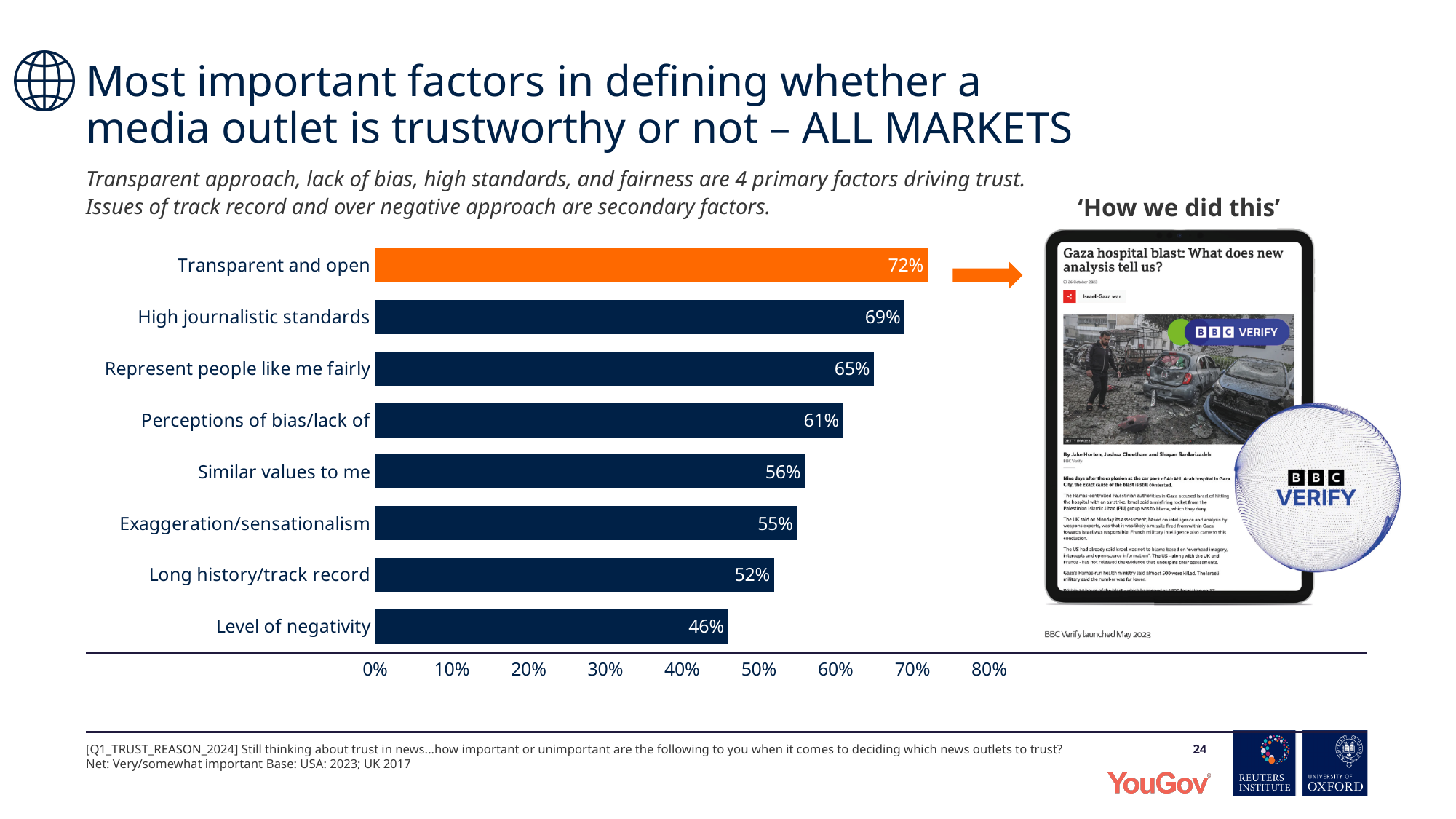
How many factors are shown in the chart? 8 Which bar is coloured orange rather than dark blue? Transparent and open What is the value for Transparent and open? 72% Is the value for Exaggeration/sensationalism greater or less than 50%? greater What is the value for Long history/track record? 52% Which factor has the highest value? Transparent and open What is the difference between High journalistic standards and Level of negativity? 23% What is the value for Similar values to me? 56% What kind of chart is shown on the slide? bar chart Which factor has the lowest value? Level of negativity Which is larger: Represent people like me fairly or Perceptions of bias/lack of? Represent people like me fairly What is the highest value shown on the percentage axis? 80%